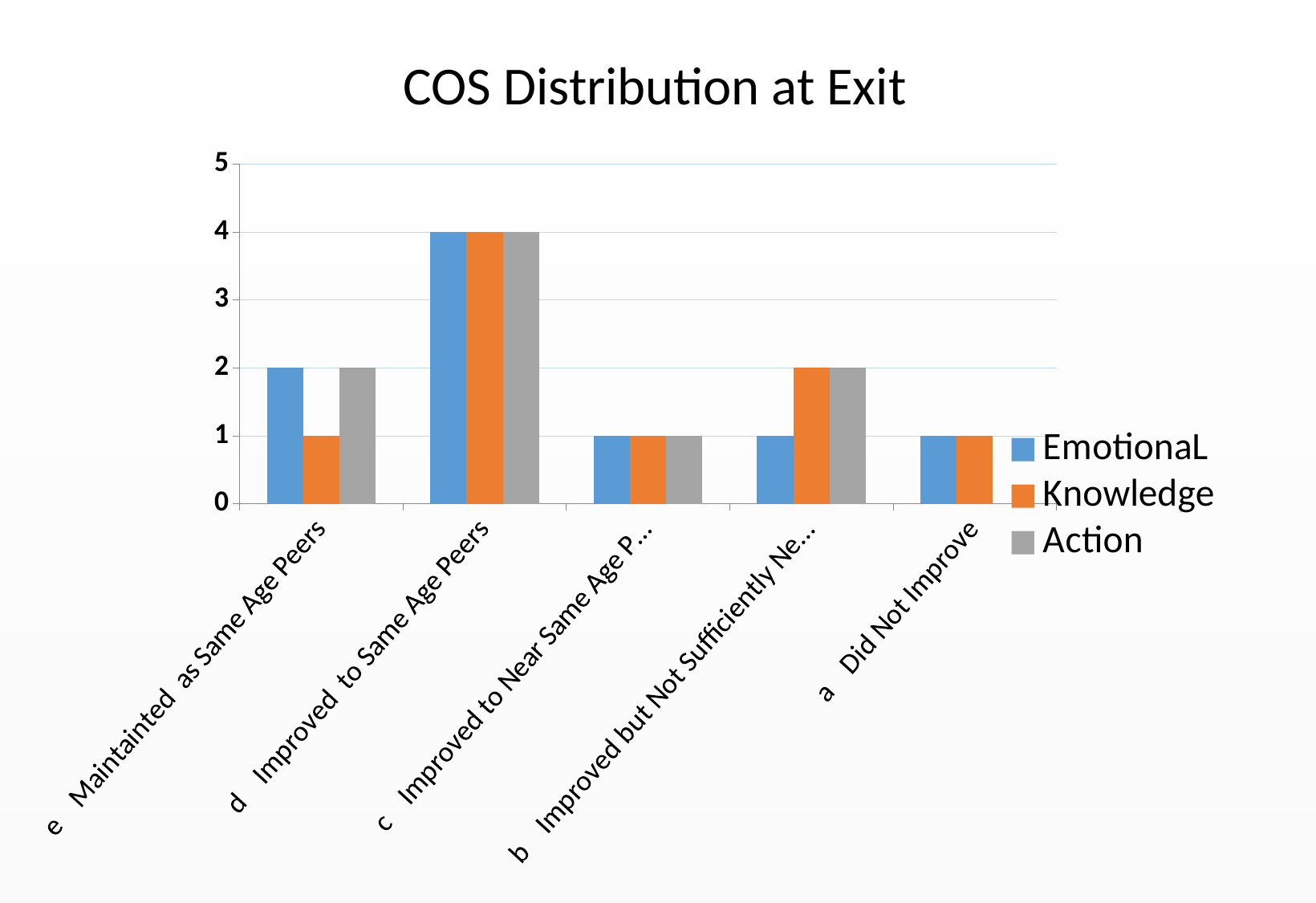
How many categories are shown on the x axis? 5 What is the title of the chart? COS Distribution at Exit Which category has the highest EmotionaL value? d Improved to Same Age Peers What kind of chart is shown on the slide? bar chart Is the Action value for "e Maintainted as Same Age Peers" greater or less than 1? greater What is the EmotionaL value for "a Did Not Improve"? 1 For "e Maintainted as Same Age Peers", which is larger: the EmotionaL value or the Knowledge value? EmotionaL What is the Action value for "d Improved to Same Age Peers"? 4 What is the Knowledge value for "e Maintainted as Same Age Peers"? 1 For "e Maintainted as Same Age Peers", what is the difference between the EmotionaL value and the Knowledge value? 1 What is the EmotionaL value for "d Improved to Same Age Peers"? 4 How many series does the legend list? 3